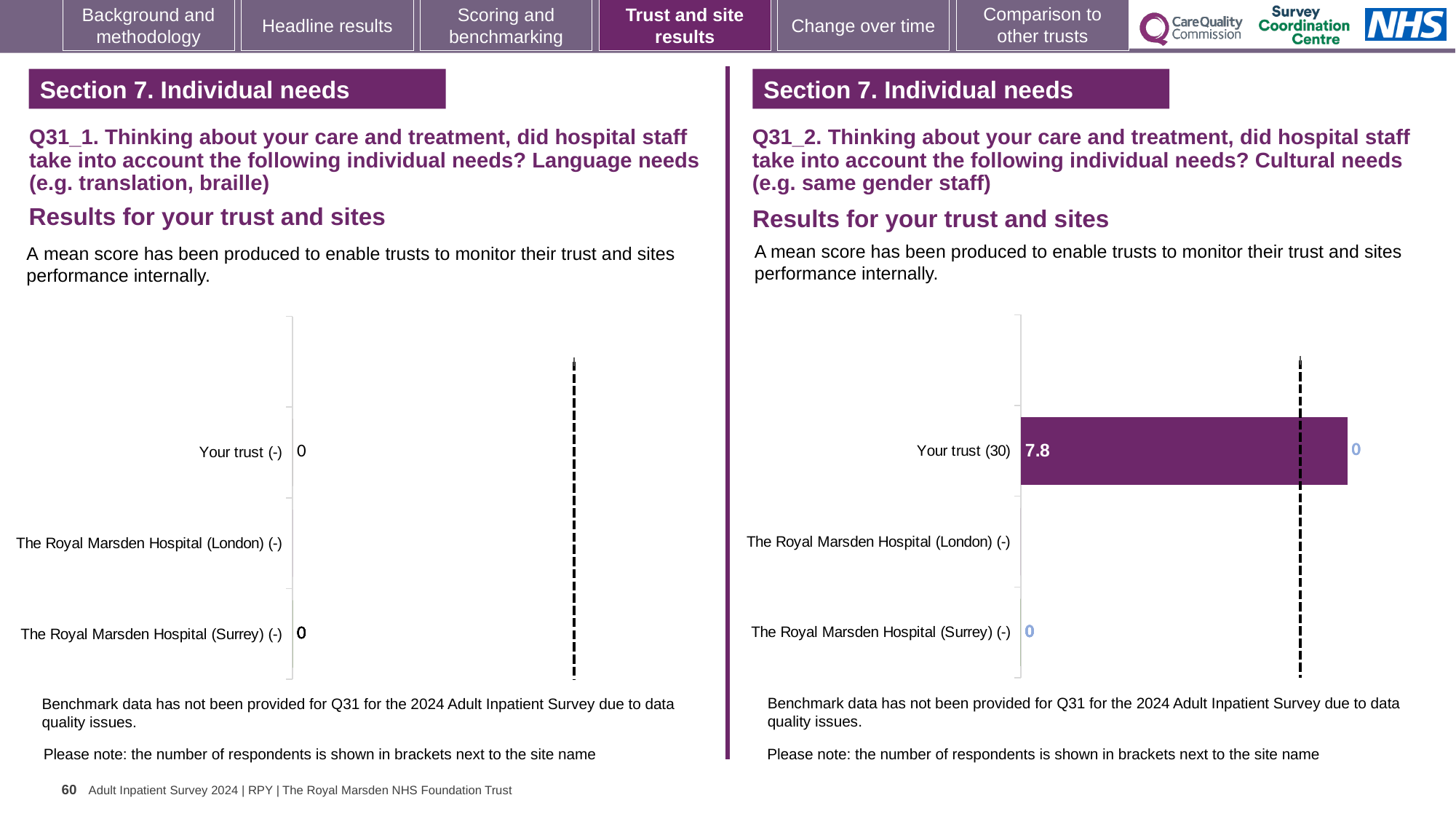
On the right chart (Q31_2, Cultural needs), which is larger: the value for Your trust (30) or for The Royal Marsden Hospital (Surrey) (-)? Your trust (30) How many categories are listed on the right chart (Q31_2, Cultural needs)? 3 On the left chart (Q31_1, Language needs), what value is shown for Your trust (-)? 0 On the right chart (Q31_2, Cultural needs), which category has the highest mean score? Your trust (30) On the right chart (Q31_2, Cultural needs), what is the mean score for Your trust (30)? 7.8 On the right chart (Q31_2, Cultural needs), how many respondents are shown in brackets for Your trust? 30 On the right chart (Q31_2, Cultural needs), what value is shown for The Royal Marsden Hospital (Surrey) (-)? 0 On the left chart (Q31_1, Language needs), what value is shown for The Royal Marsden Hospital (Surrey) (-)? 0 How many categories are listed on the left chart (Q31_1, Language needs)? 3 What kind of chart is used on the right side of the slide (Q31_2, Cultural needs)? Bar chart On the right chart (Q31_2, Cultural needs), what is the difference between the value for Your trust (30) and The Royal Marsden Hospital (Surrey) (-)? 7.8 On the right chart (Q31_2, Cultural needs), what colour is the bar for Your trust (30)? Purple